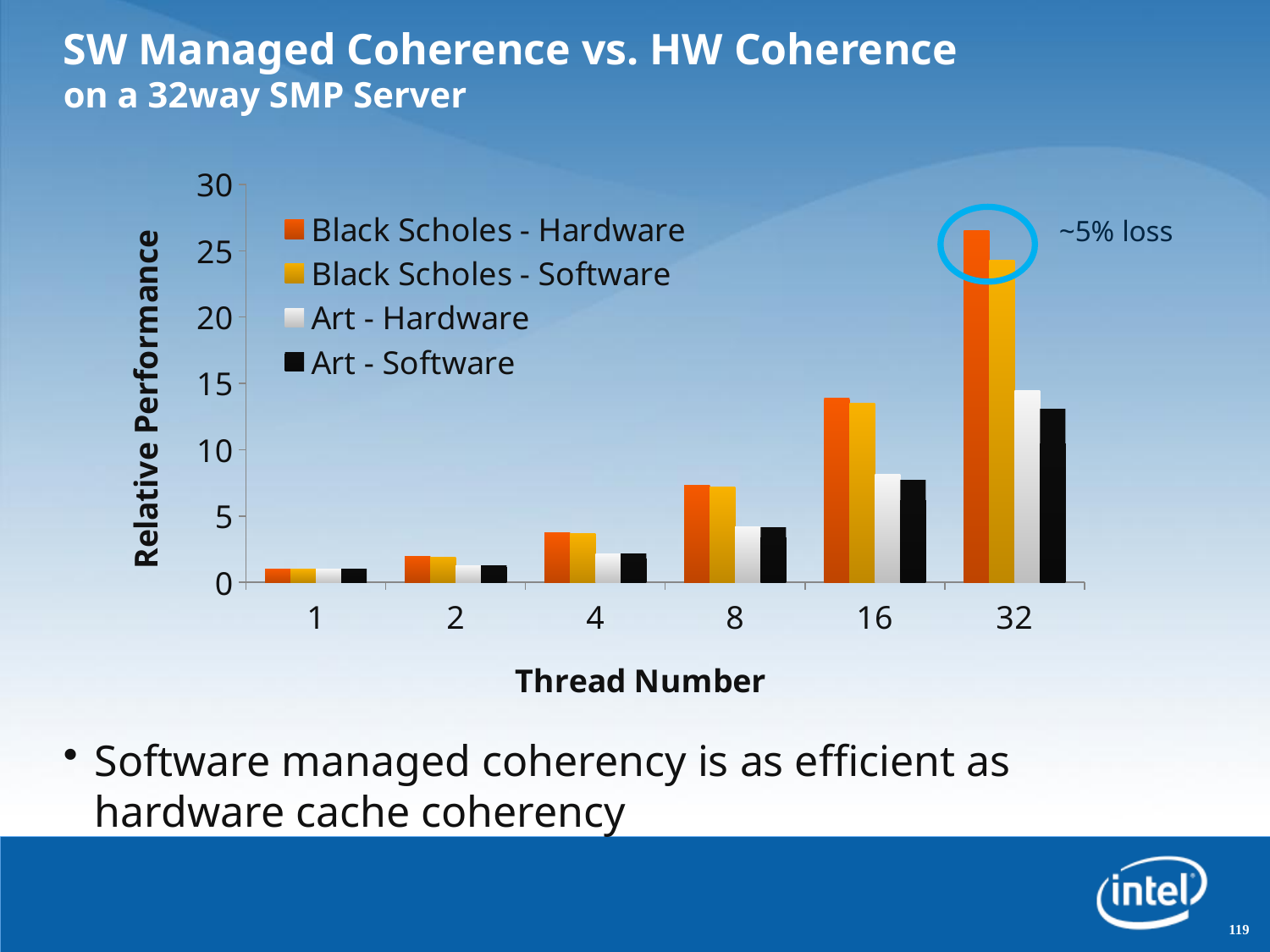
Do the values for Black Scholes - Hardware rise or fall as the thread number increases? rise Is the value for Black Scholes - Hardware at 16 threads greater or less than 10? greater Is the value for Art - Software at 32 threads greater or less than 15? less How many series does the chart legend list? 4 At 32 threads, which is larger: Black Scholes - Hardware or Art - Software? Black Scholes - Hardware Which series has the tallest bar at 32 threads? Black Scholes - Hardware How many thread-number categories are shown on the x axis? 6 Is the value for Black Scholes - Hardware at 32 threads greater or less than 25? greater What kind of chart is shown on the slide? bar chart What annotation is written next to the circled bars at 32 threads? ~5% loss What is the title of the y axis? Relative Performance